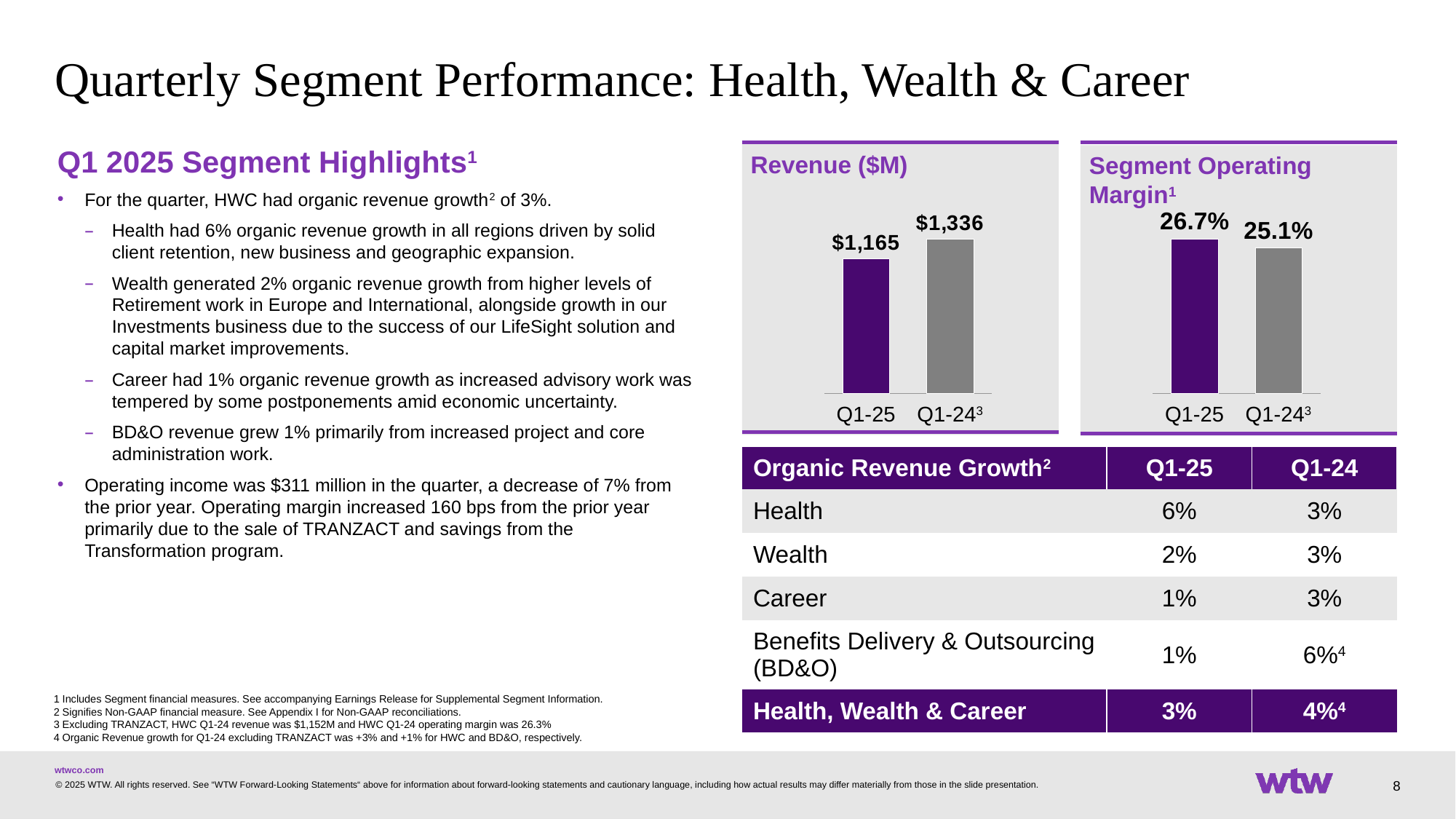
In the Revenue ($M) chart, which period has the higher revenue? Q1-24 What type of chart is the Segment Operating Margin chart? bar chart In the Segment Operating Margin chart, what is the value for Q1-25? 26.7% In the Revenue ($M) chart, what is the value for Q1-24? $1,336 In the Revenue ($M) chart, what is the value for Q1-25? $1,165 In the Segment Operating Margin chart, what is the value for Q1-24? 25.1% In the Segment Operating Margin chart, is the Q1-25 value larger or smaller than the Q1-24 value? larger In the Segment Operating Margin chart, which period has the lower margin? Q1-24 In the Revenue ($M) chart, what is the difference between the Q1-24 and Q1-25 values? $171 How many bars are shown in the Revenue ($M) chart? 2 In the Revenue ($M) chart, what colour is the Q1-25 bar? purple In the Segment Operating Margin chart, what is the difference between the Q1-25 and Q1-24 values? 1.6%